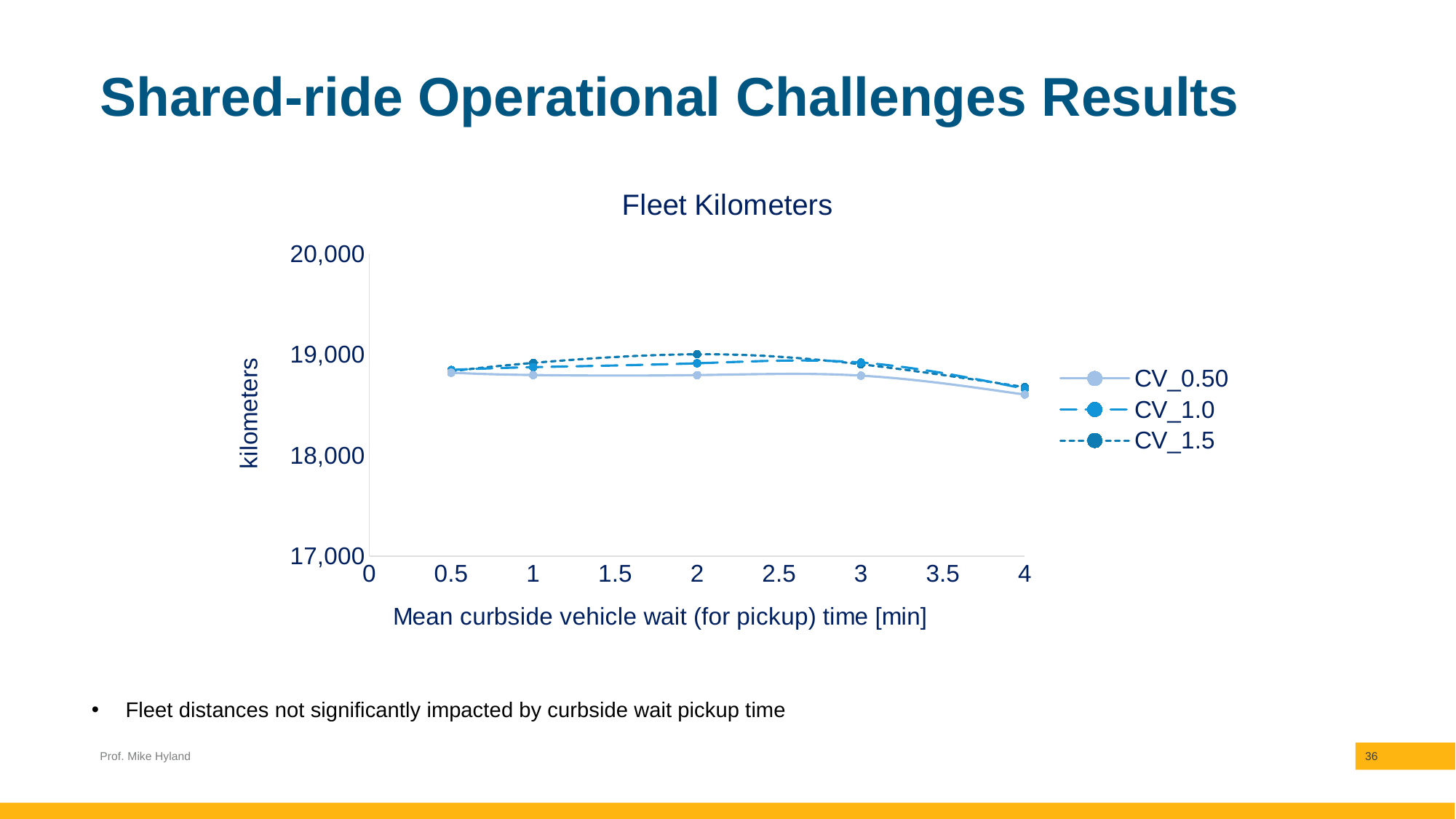
Is the value for CV_1.5 at a mean curbside wait time of 2 minutes greater or less than 18,000? greater Which series has the lowest value at a mean curbside wait time of 4 minutes? CV_0.50 What is the label of the x axis? Mean curbside vehicle wait (for pickup) time [min] Which series has the highest value at a mean curbside wait time of 2 minutes? CV_1.5 How many data points are plotted for the CV_0.50 series? 5 How many series does the legend list? 3 Is the value for CV_0.50 at a mean curbside wait time of 4 minutes greater or less than 19,000? less Does the CV_0.50 series rise or fall between a mean curbside wait time of 3 minutes and 4 minutes? fall What is the title of the chart? Fleet Kilometers Is the value for CV_1.0 at a mean curbside wait time of 0.5 minutes greater or less than 18,000? greater What kind of chart is shown on the slide? line chart At a mean curbside wait time of 2 minutes, which is larger: CV_1.5 or CV_0.50? CV_1.5